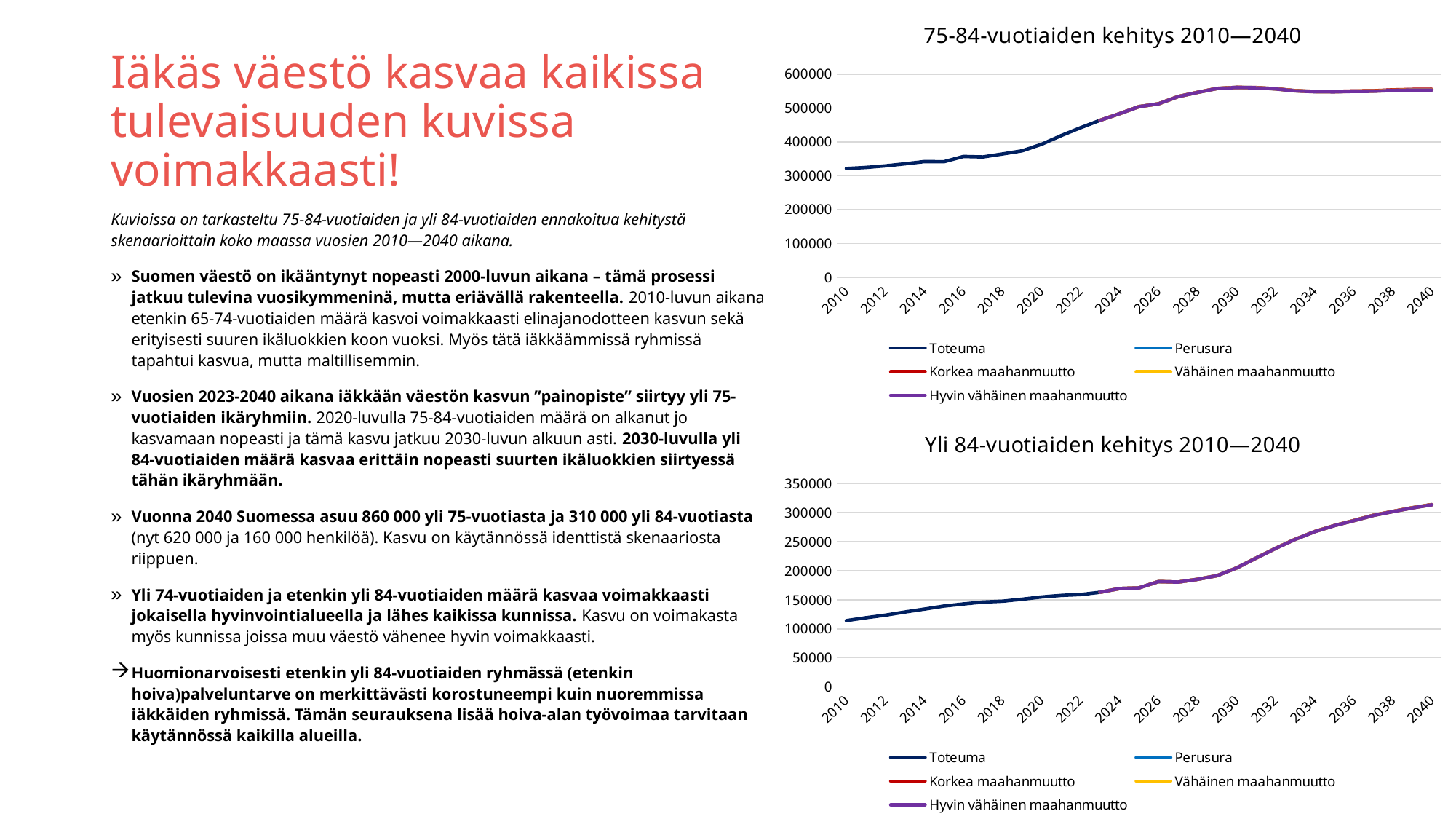
In the 'Yli 84-vuotiaiden kehitys 2010—2040' chart, is the value for 2010 greater or less than 100000? greater In the '75-84-vuotiaiden kehitys 2010—2040' chart, is the value for 2040 greater or less than 600000? less What kind of chart is the '75-84-vuotiaiden kehitys 2010—2040' chart? line chart In the 'Yli 84-vuotiaiden kehitys 2010—2040' chart, is the value for 2040 greater or less than 300000? greater Which legend entry in the '75-84-vuotiaiden kehitys 2010—2040' chart is shown in purple? Hyvin vähäinen maahanmuutto In the 'Yli 84-vuotiaiden kehitys 2010—2040' chart, do the values rise or fall from 2010 to 2040? rise In the '75-84-vuotiaiden kehitys 2010—2040' chart, which year has a higher value, 2010 or 2030? 2030 How many series does the legend of the 'Yli 84-vuotiaiden kehitys 2010—2040' chart list? 5 How many year labels are shown on the x axis of the 'Yli 84-vuotiaiden kehitys 2010—2040' chart? 16